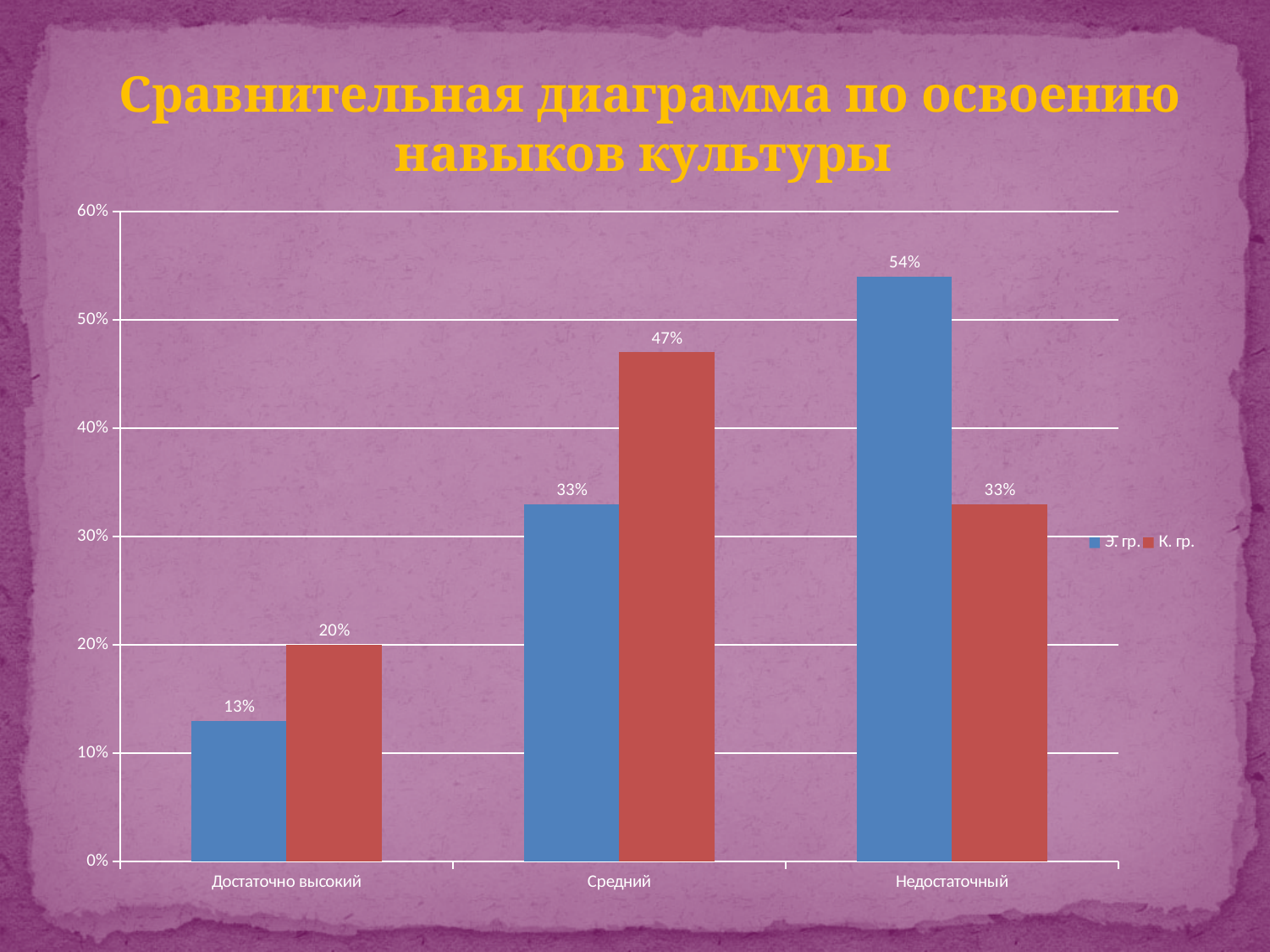
What is the value for К. гр. in the Достаточно высокий category? 20% How many categories are shown on the x axis? 3 Which category has the lowest value for К. гр.? Достаточно высокий What is the value for К. гр. in the Средний category? 47% What colour are the bars for К. гр.? Red How many series does the legend list? 2 What is the value for Э. гр. in the Недостаточный category? 54% What is the value for Э. гр. in the Достаточно высокий category? 13% Which category has the highest value for Э. гр.? Недостаточный What kind of chart is shown on the slide? Bar chart Which is larger in the Недостаточный category, Э. гр. or К. гр.? Э. гр. What is the difference between К. гр. and Э. гр. in the Средний category? 14%